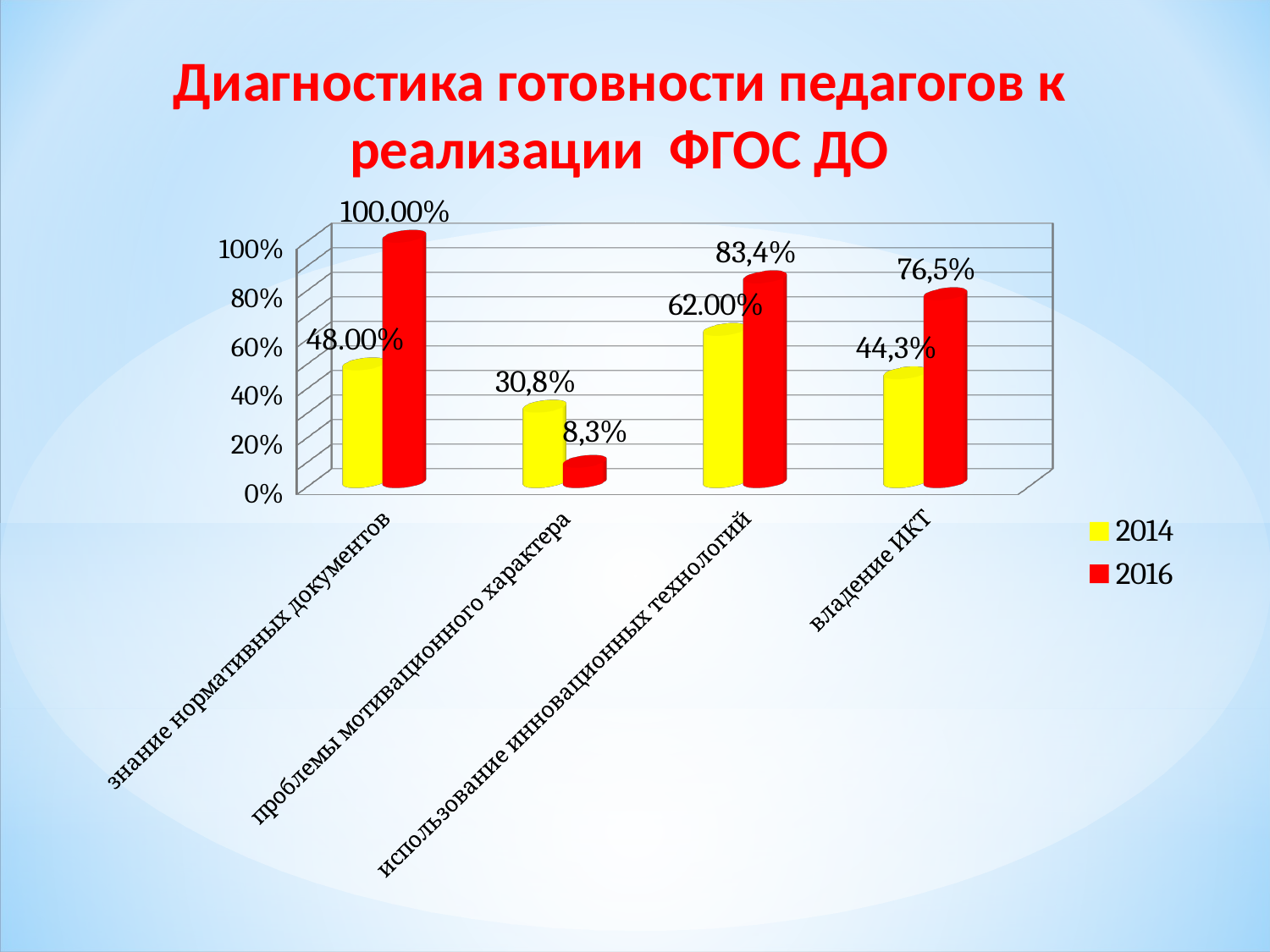
Which category has the lowest 2014 value? проблемы мотивационного характера What is the 2014 value for использование инновационных технологий? 62.00% What is the 2016 value for проблемы мотивационного характера? 8,3% What type of chart is shown on the slide? bar chart Which category has the highest 2016 value? знание нормативных документов What is the 2016 value for знание нормативных документов? 100.00% What is the difference between the 2016 and 2014 values for владение ИКТ? 32,2% What is the 2014 value for знание нормативных документов? 48.00% How many series does the legend list? 2 Which is larger for проблемы мотивационного характера, the 2014 value or the 2016 value? 2014 What is the 2016 value for владение ИКТ? 76,5% How many categories are shown on the x axis? 4